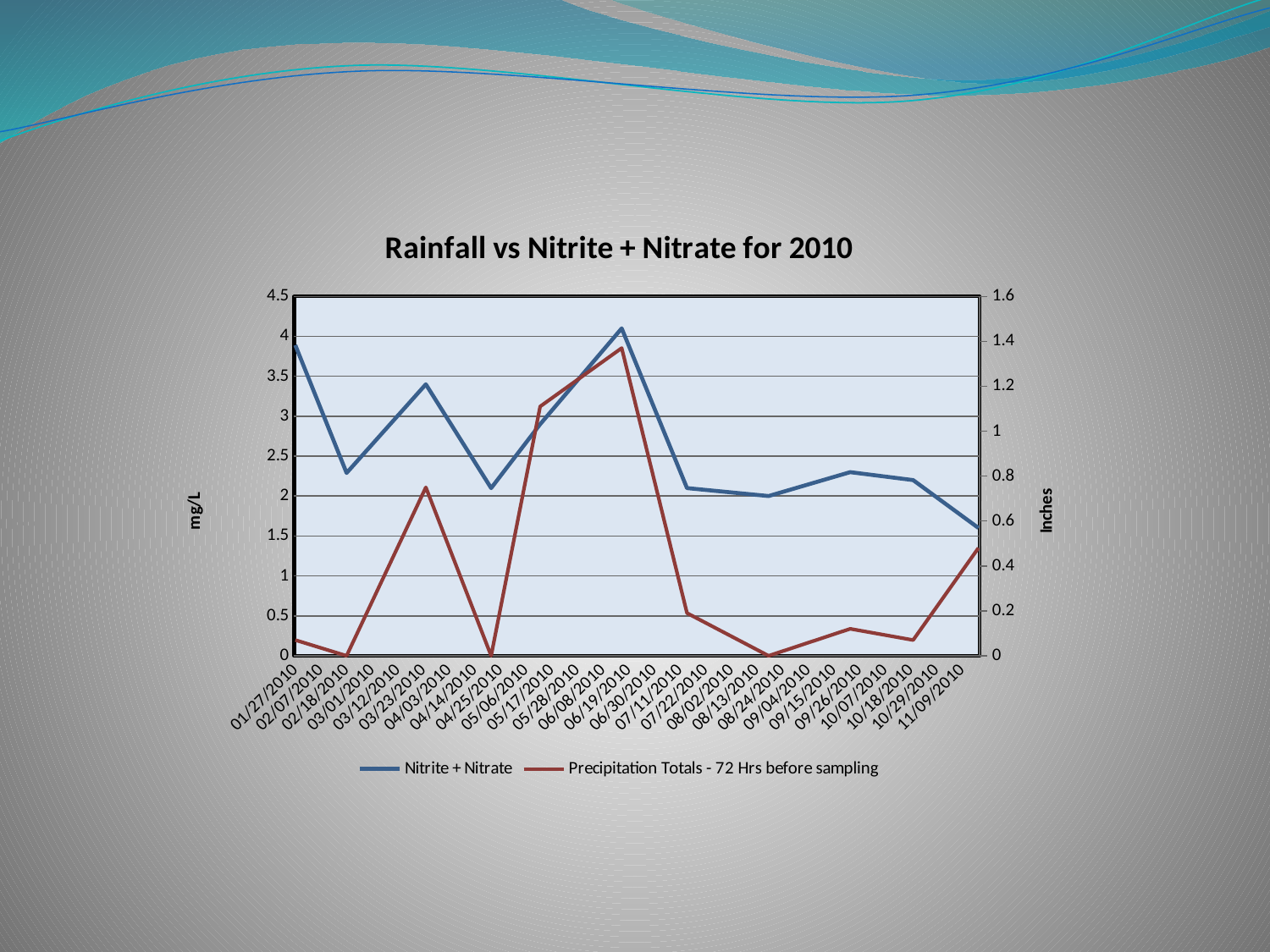
Is the Nitrite + Nitrate value for 01/27/2010 greater or less than 3.5? greater What is the label on the right-hand vertical axis? Inches How many series does the legend list? 2 What is the title of the chart? Rainfall vs Nitrite + Nitrate for 2010 What kind of chart is shown on the slide? line chart